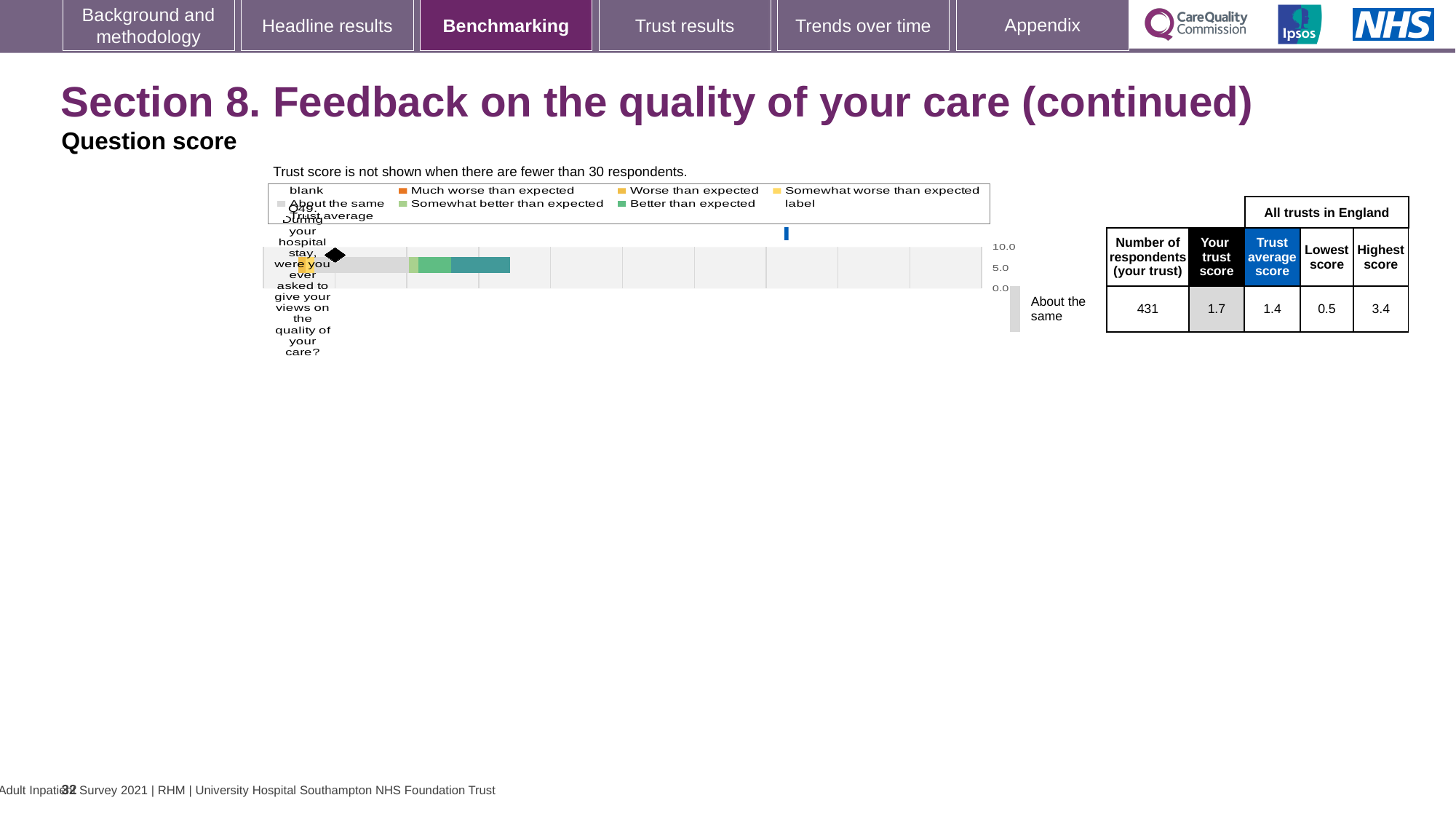
How many respondents from the trust answered Q49, according to the table beside the chart? 431 What kind of chart is shown on the slide? bar chart How many question bars are plotted in the chart? 1 What is the difference between the highest score and the lowest score for Q49 in the table beside the chart? 2.9 Which question number is plotted in the chart? Q49 Which is larger for Q49: the trust score or the trust average score? the trust score What benchmark category label is shown to the right of the chart for Q49? About the same According to the table beside the chart, what is the highest score among all trusts in England for Q49? 3.4 According to the table beside the chart, what is the trust average score for Q49? 1.4 Which legend entry in the chart is shown in orange? Much worse than expected According to the table beside the chart, what is the lowest score among all trusts in England for Q49? 0.5 According to the table beside the chart, what is the trust score for Q49? 1.7